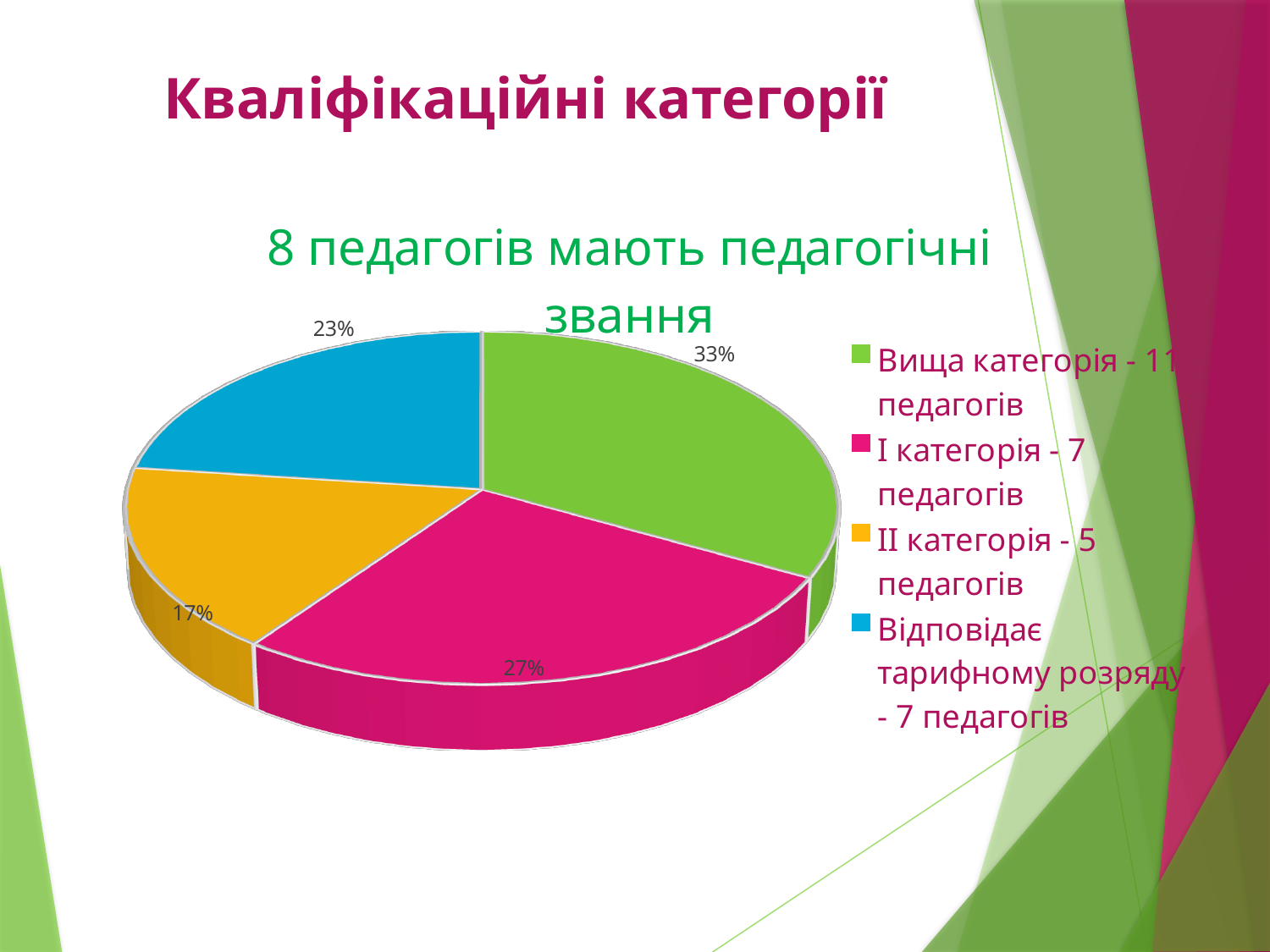
What share of the pie does the slice for "Вища категорія" represent? 33% Which category has the smallest slice of the pie? ІІ категорія How many slices does the pie chart have? 4 What colour is the slice for "Відповідає тарифному розряду"? blue What share of the pie does the slice for "Відповідає тарифному розряду" represent? 23% What kind of chart is shown on the slide? pie chart What share of the pie does the slice for "ІІ категорія" represent? 17% What is the difference in percentage points between the "Вища категорія" slice and the "ІІ категорія" slice? 16 Which slice is larger: "І категорія" or "Відповідає тарифному розряду"? І категорія Which category has the largest slice of the pie? Вища категорія How many entries does the legend list? 4